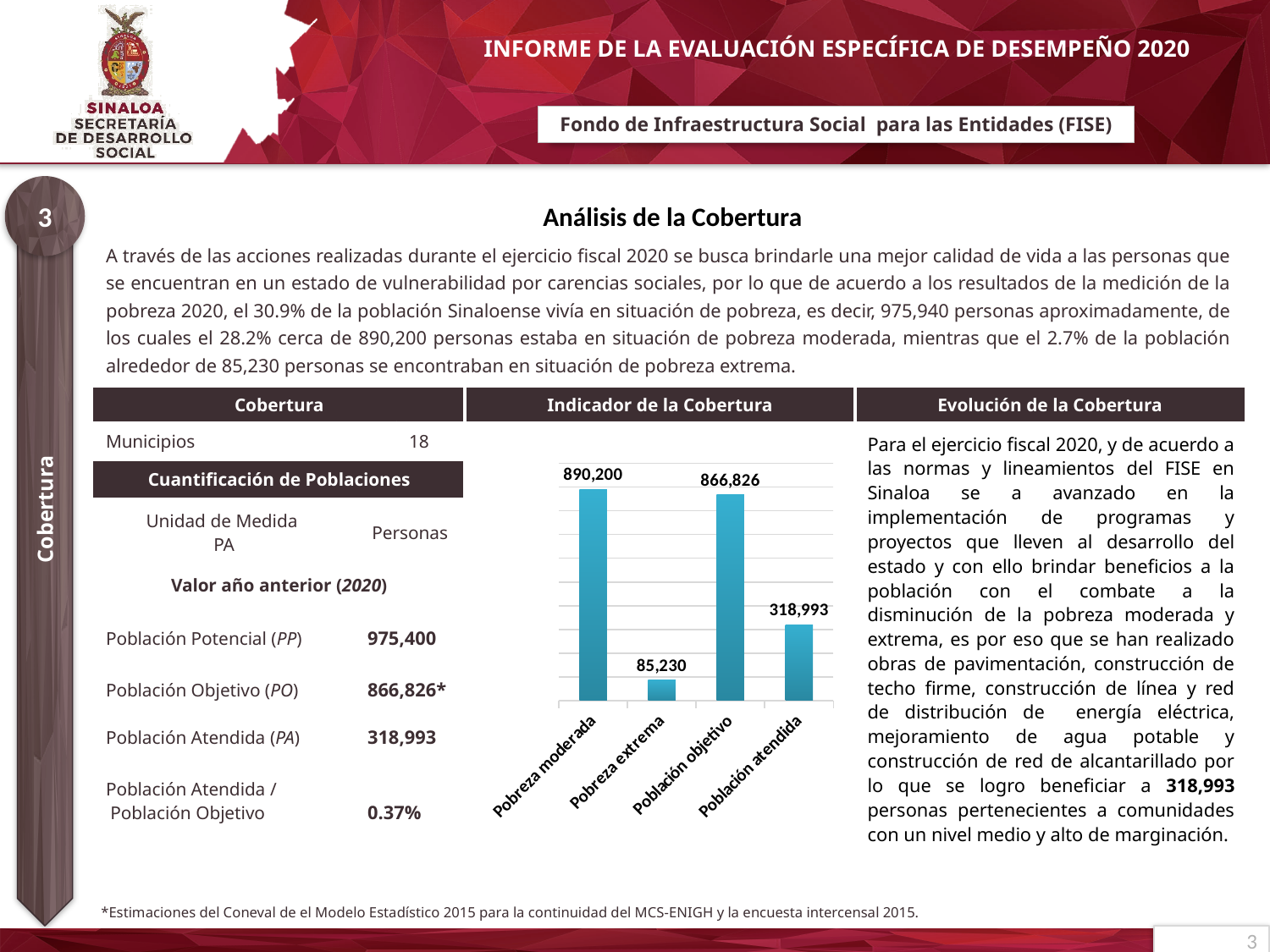
Which category has the highest value in the chart? Pobreza moderada How many categories are shown in the chart? 4 What is the value for Población objetivo in the chart? 866,826 What is the value for Población atendida in the chart? 318,993 What is the heading above the chart on the slide? Indicador de la Cobertura What is the value for Pobreza extrema in the chart? 85,230 What is the difference between the values for Población objetivo and Población atendida? 547,833 Which category has the lowest value in the chart? Pobreza extrema Which is larger, the value for Población atendida or the value for Pobreza extrema? Población atendida What is the value for Pobreza moderada in the chart? 890,200 What is the difference between the values for Pobreza moderada and Pobreza extrema? 804,970 What kind of chart is shown on the slide? Bar chart